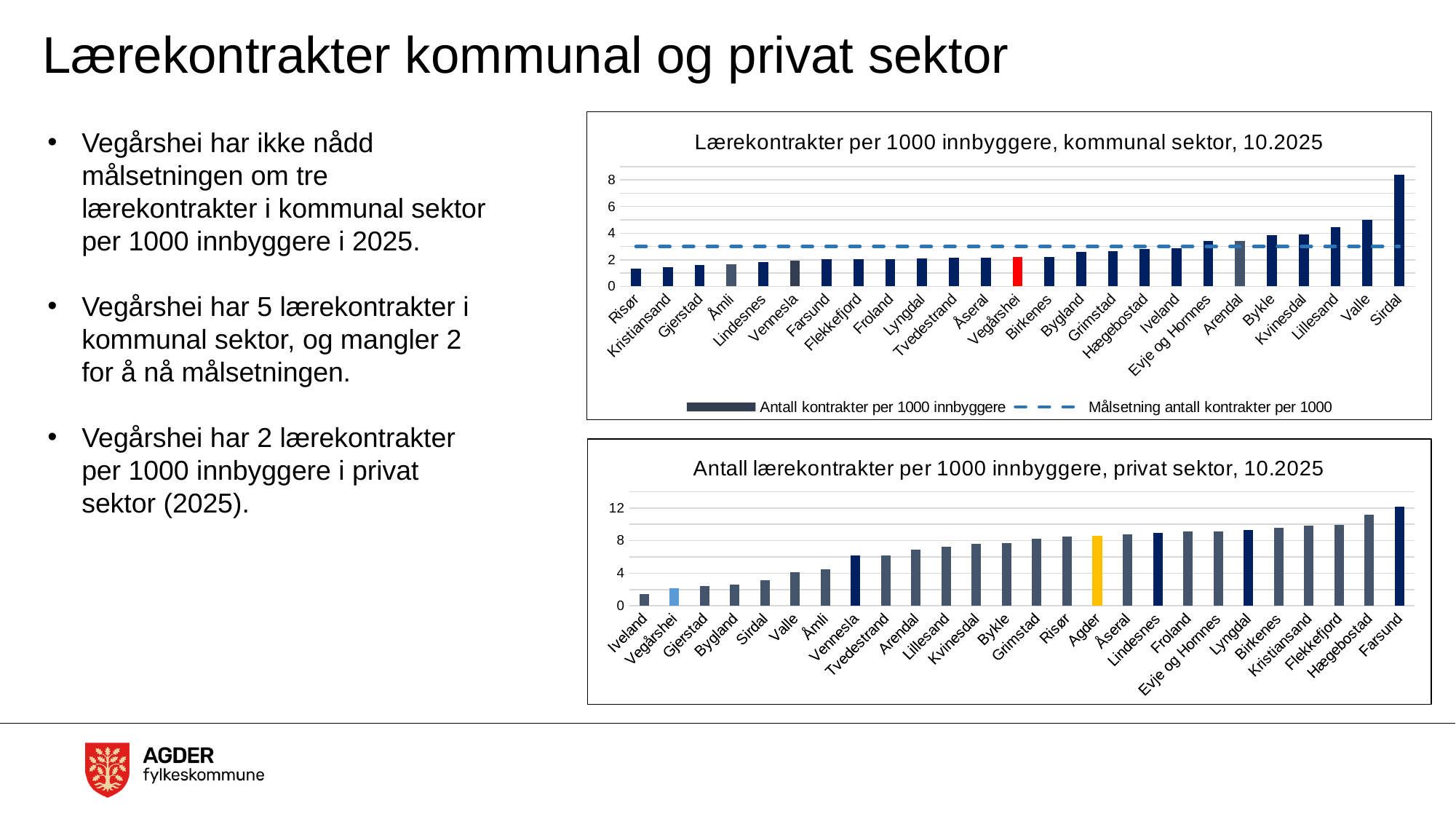
In the top chart (kommunal sektor), is the value for Risør greater or less than 2? less In the top chart (kommunal sektor), is the value for Sirdal greater or less than 6? greater In the bottom chart (privat sektor), which municipality has the lowest value? Iveland In the top chart (kommunal sektor), how many entries does the legend list? 2 In the chart titled 'Lærekontrakter per 1000 innbyggere, kommunal sektor, 10.2025', which municipality has the highest value? Sirdal In the bottom chart (privat sektor), which is larger, the value for Farsund or the value for Iveland? Farsund In the chart titled 'Antall lærekontrakter per 1000 innbyggere, privat sektor, 10.2025', which municipality has the highest value? Farsund In the top chart (kommunal sektor), what colour is the bar for Vegårshei? Red In the bottom chart (privat sektor), do the values rise or fall from left to right along the x axis? Rise In the top chart (kommunal sektor), how many municipalities are shown on the x axis? 25 In the bottom chart (privat sektor), is the value for Farsund greater or less than 8? greater What kind of chart is the bottom chart (privat sektor)? Bar chart